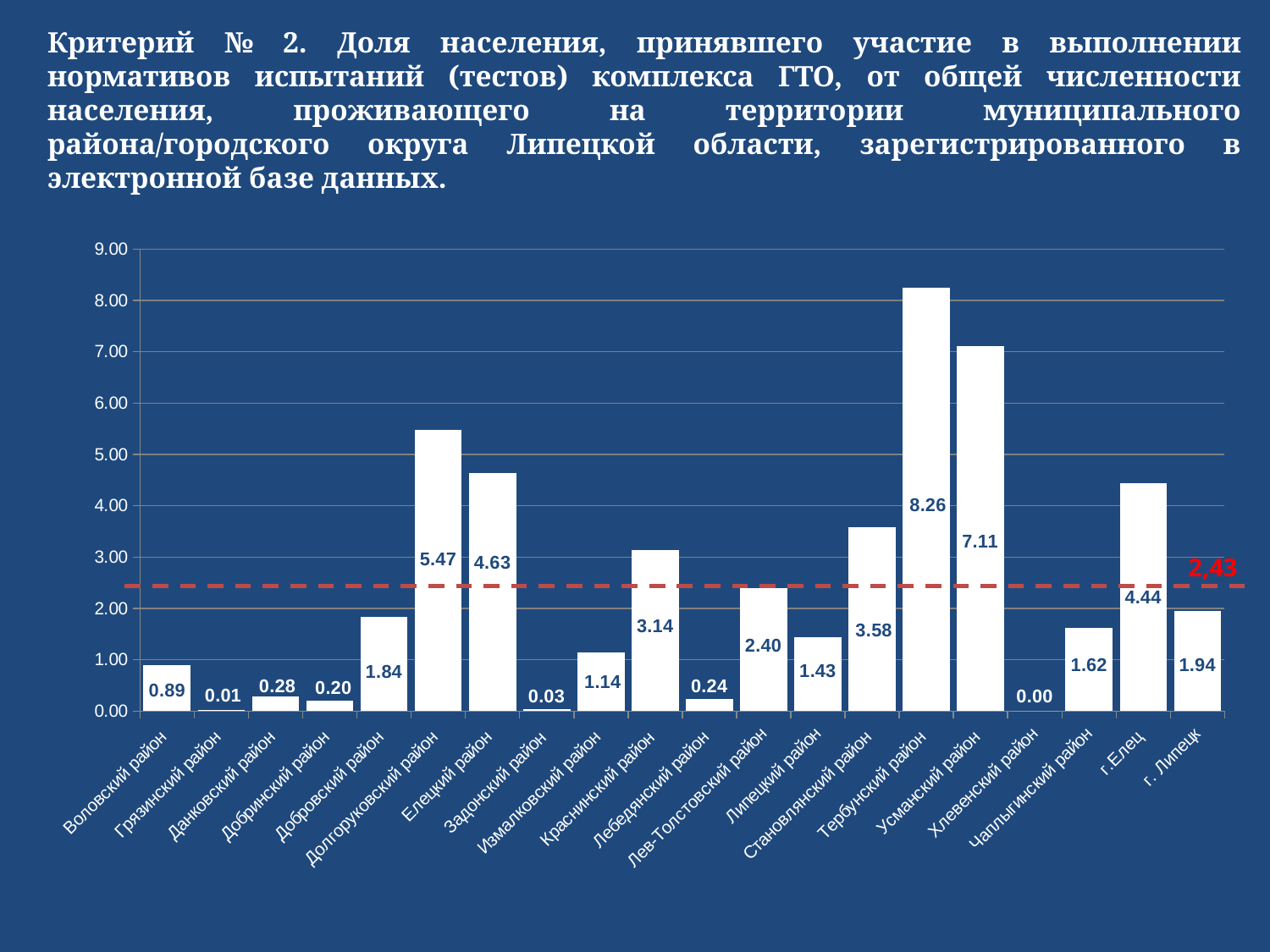
How many categories are shown on the x axis? 20 What is the value for Долгоруковский район? 5.47 What value is marked by the red dashed horizontal line? 2,43 Which is larger, the value for Елецкий район or the value for г.Елец? Елецкий район What is the difference between the values for Краснинский район and Измалковский район? 2.00 What kind of chart is shown on the slide? bar chart Which category has the lowest value? Хлевенский район What is the value for г. Липецк? 1.94 Which category has the highest value? Тербунский район What is the difference between the values for Тербунский район and Усманский район? 1.15 Is the value for Становлянский район greater or less than 3.00? greater What is the value for Тербунский район? 8.26